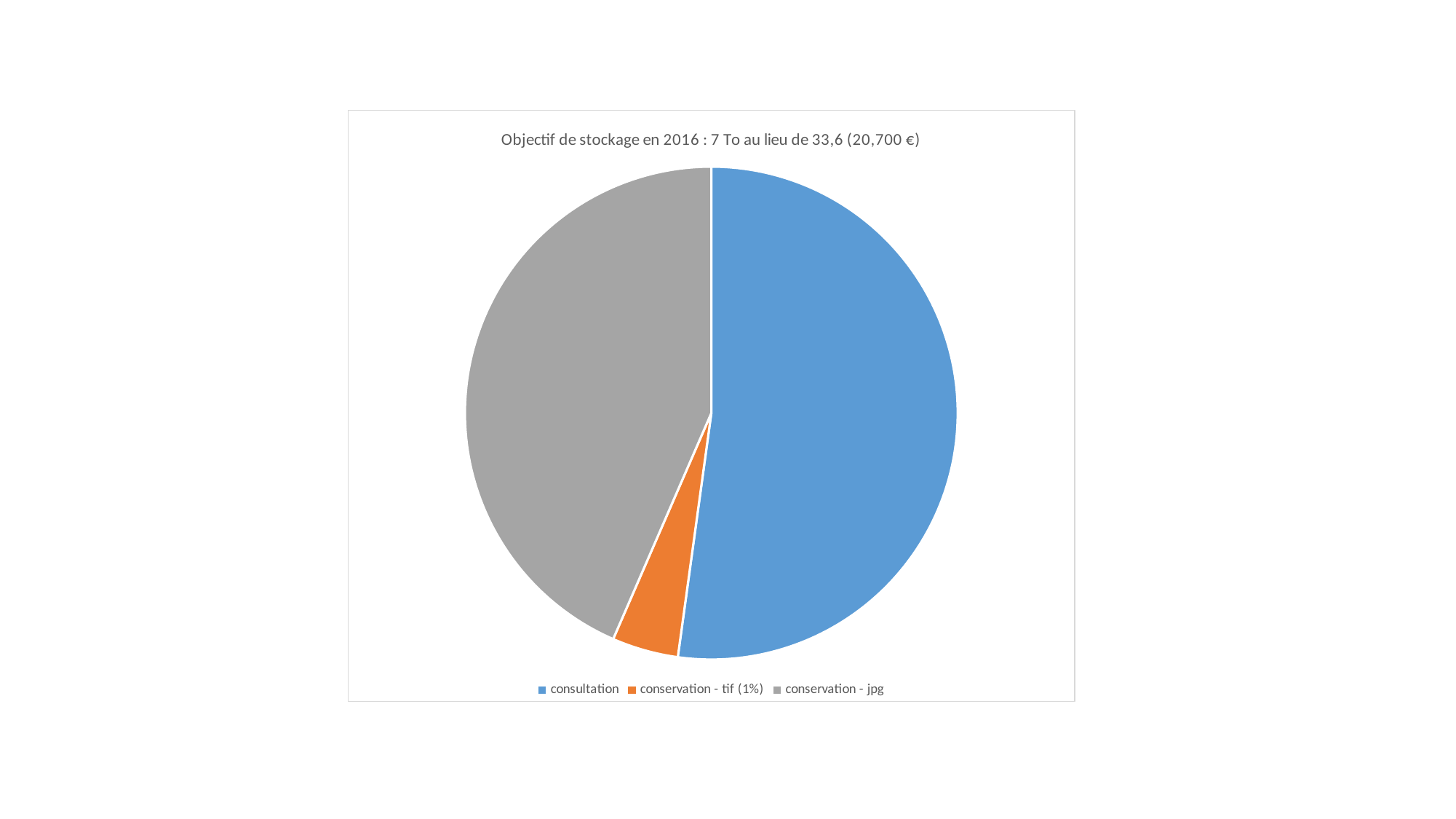
What percentage share is given in the legend for the conservation - tif slice? 1% Which slice is larger, consultation or conservation - tif? consultation How many entries does the legend list? 3 What is the title of the chart? Objectif de stockage en 2016 : 7 To au lieu de 33,6 (20,700 €) What colour is the consultation slice? blue How many slices does the pie chart have? 3 Which category has the smallest slice of the pie? conservation - tif (1%) What kind of chart is shown on the slide? pie chart Which category has the largest slice of the pie? consultation Which slice is larger, conservation - jpg or conservation - tif? conservation - jpg